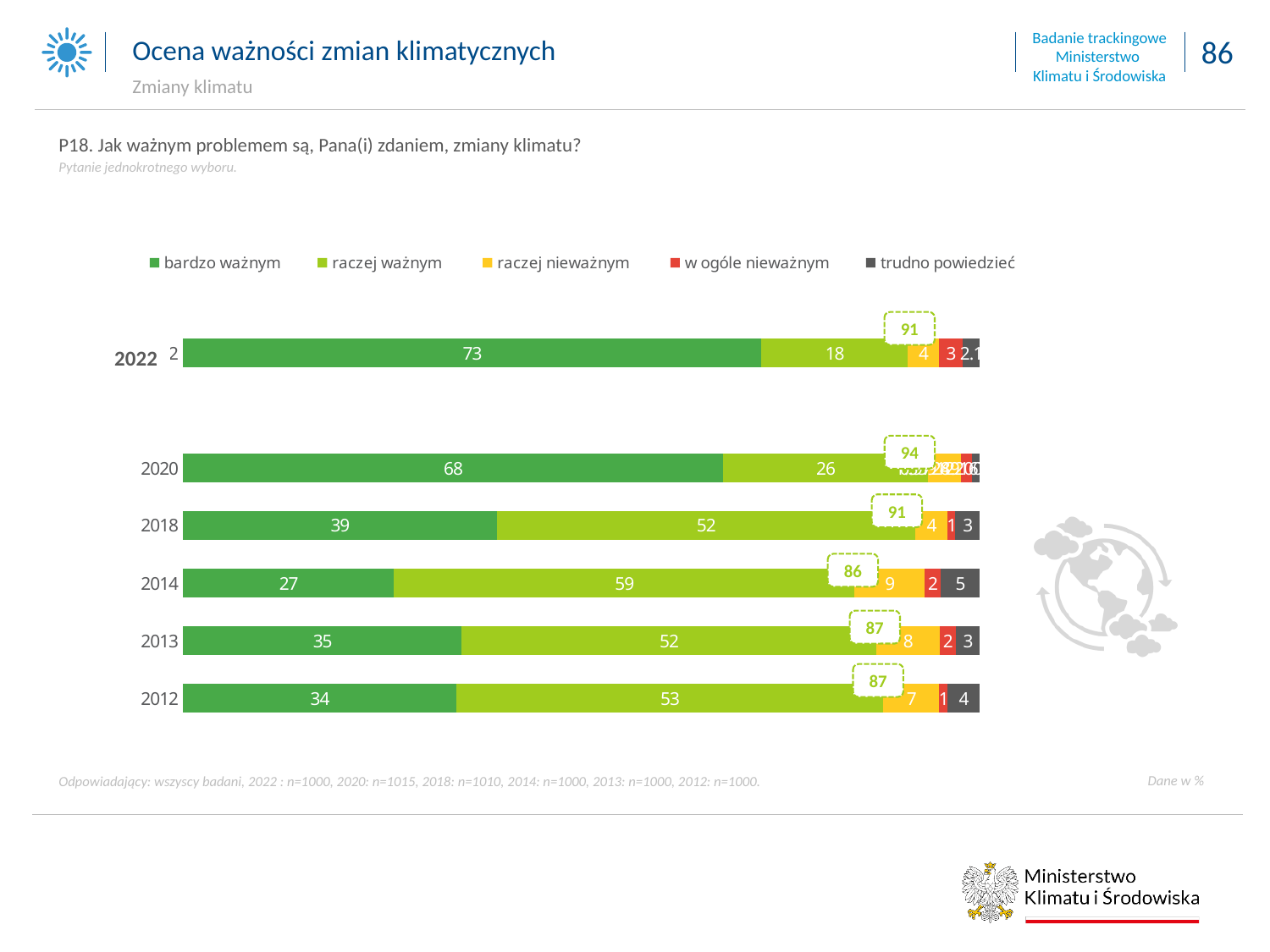
What is the difference between the "bardzo ważnym" values for 2022 and 2020? 5 What kind of chart is shown on the slide? stacked bar chart Which is larger: the "raczej ważnym" value for 2018 or for 2020? 2018 Which year has the highest value for "bardzo ważnym"? 2022 What is the combined value shown in the callout for 2014? 86 Which year has the lowest value for "bardzo ważnym"? 2014 What is the value for "bardzo ważnym" in 2022? 73 What is the value for "raczej ważnym" in 2014? 59 What is the value for "trudno powiedzieć" in 2012? 4 What is the value for "raczej nieważnym" in 2013? 8 How many series does the legend list? 5 How many years (categories) are shown in the chart? 6